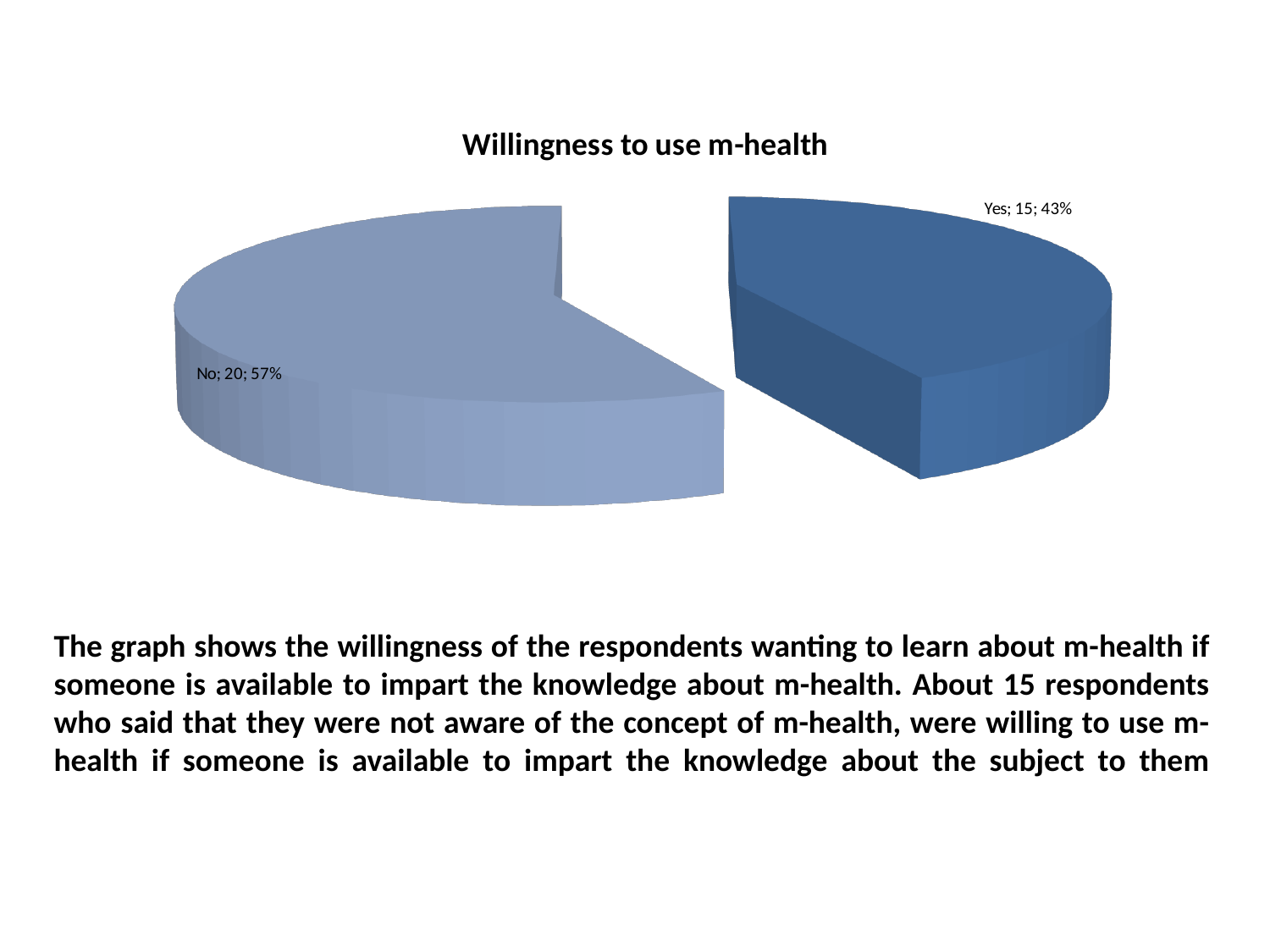
What kind of chart is shown on the slide? pie chart What share of the pie does the "Yes" slice represent? 43% How many respondents answered "Yes"? 15 What is the difference in the number of respondents between "No" and "Yes"? 5 How many respondents answered "No"? 20 What share of the pie does the "No" slice represent? 57% What is the title of the chart? Willingness to use m-health Which category has the largest slice? No Which is larger, the "Yes" slice or the "No" slice? No What is the total number of respondents shown in the pie chart? 35 Which category has the smallest slice? Yes How many slices does the pie chart have? 2